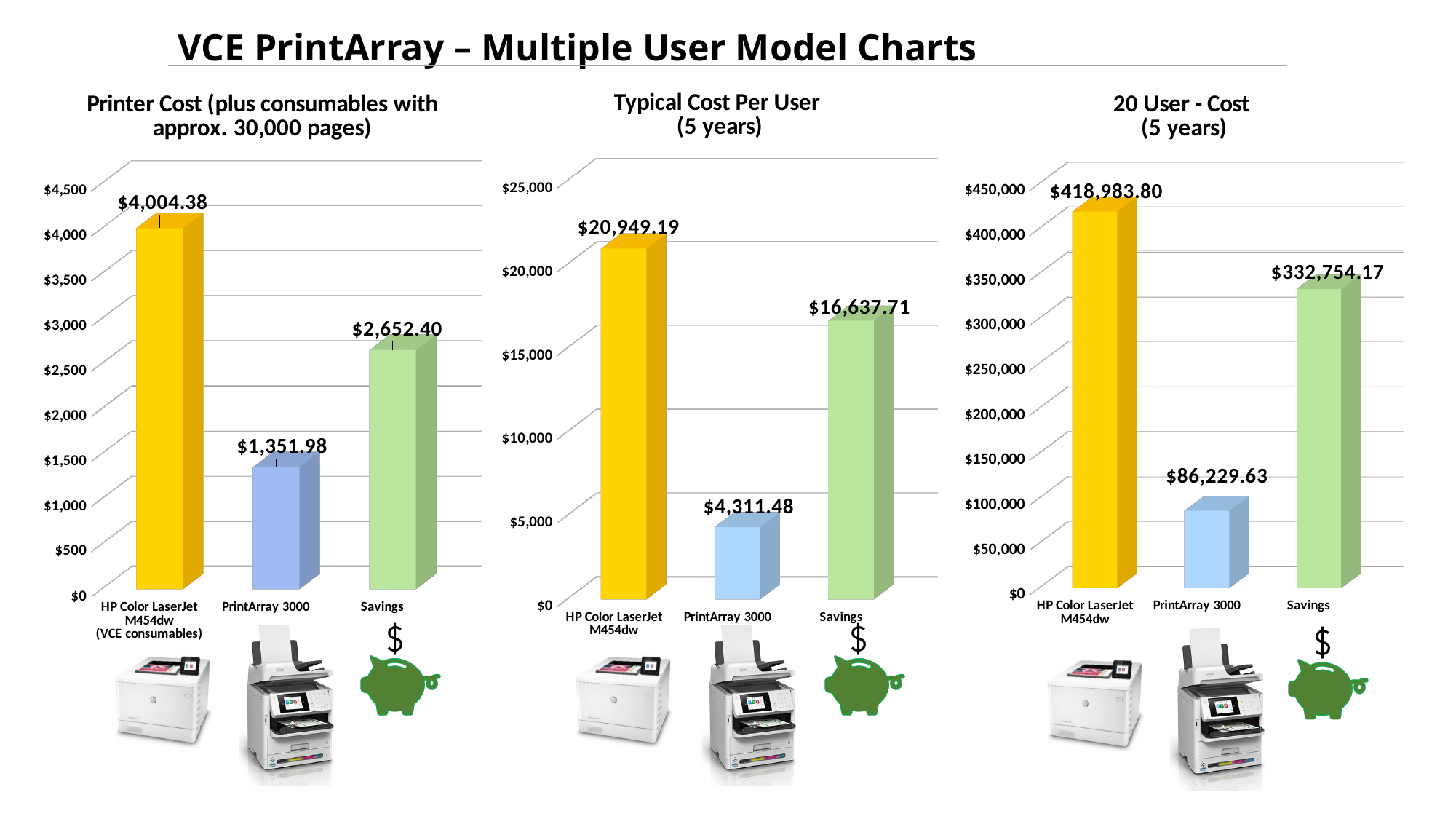
In the '20 User - Cost (5 years)' chart, what is the difference between the HP Color LaserJet M454dw value and the Savings value? $86,229.63 What kind of chart is the 'Typical Cost Per User (5 years)' chart? bar chart In the 'Typical Cost Per User (5 years)' chart, what is the value for Savings? $16,637.71 In the 'Typical Cost Per User (5 years)' chart, which is larger: the value for Savings or the value for PrintArray 3000? Savings In the 'Typical Cost Per User (5 years)' chart, is the value for HP Color LaserJet M454dw greater or less than $20,000? greater In the 'Printer Cost (plus consumables with approx. 30,000 pages)' chart, what is the value for HP Color LaserJet M454dw (VCE consumables)? $4,004.38 In the 'Typical Cost Per User (5 years)' chart, which category has the lowest value? PrintArray 3000 How many categories are shown in the '20 User - Cost (5 years)' chart? 3 In the '20 User - Cost (5 years)' chart, what is the value for PrintArray 3000? $86,229.63 In the 'Printer Cost (plus consumables with approx. 30,000 pages)' chart, what is the value for PrintArray 3000? $1,351.98 In the 'Printer Cost (plus consumables with approx. 30,000 pages)' chart, what is the difference between the HP Color LaserJet M454dw value and the PrintArray 3000 value? $2,652.40 In the '20 User - Cost (5 years)' chart, which category has the highest value? HP Color LaserJet M454dw